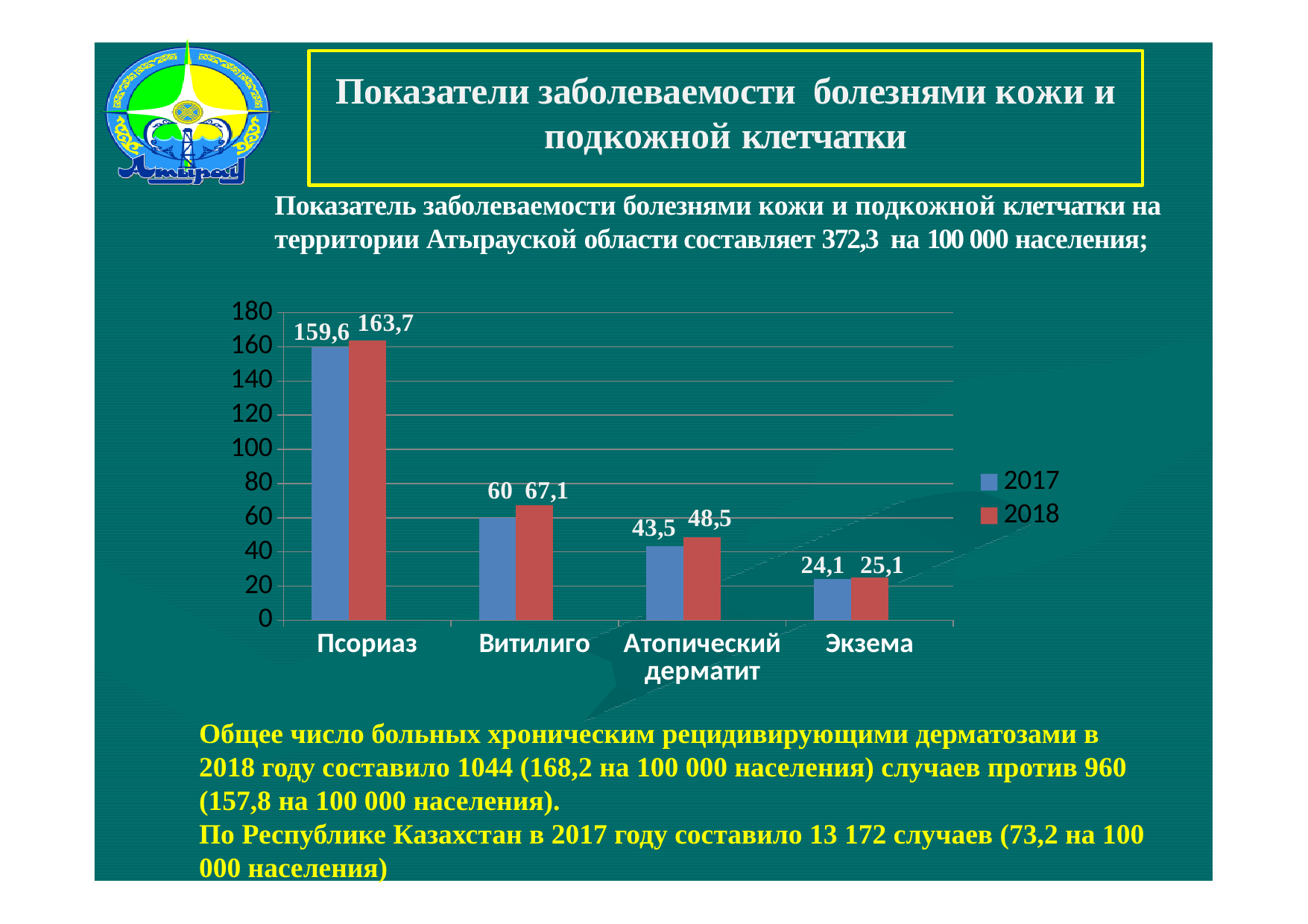
What kind of chart is shown on the slide? Bar chart What is the 2018 value for Экзема? 25,1 How many categories are shown on the x axis? 4 What is the difference between the 2018 and 2017 values for Псориаз? 4,1 What is the difference between the 2018 and 2017 values for Витилиго? 7,1 Which is larger for Атопический дерматит: the 2017 value or the 2018 value? 2018 How many series does the legend list? 2 What is the 2017 value for Псориаз? 159,6 What is the 2018 value for Витилиго? 67,1 Which category has the lowest 2017 value? Экзема Which category has the highest 2018 value? Псориаз What is the 2017 value for Атопический дерматит? 43,5